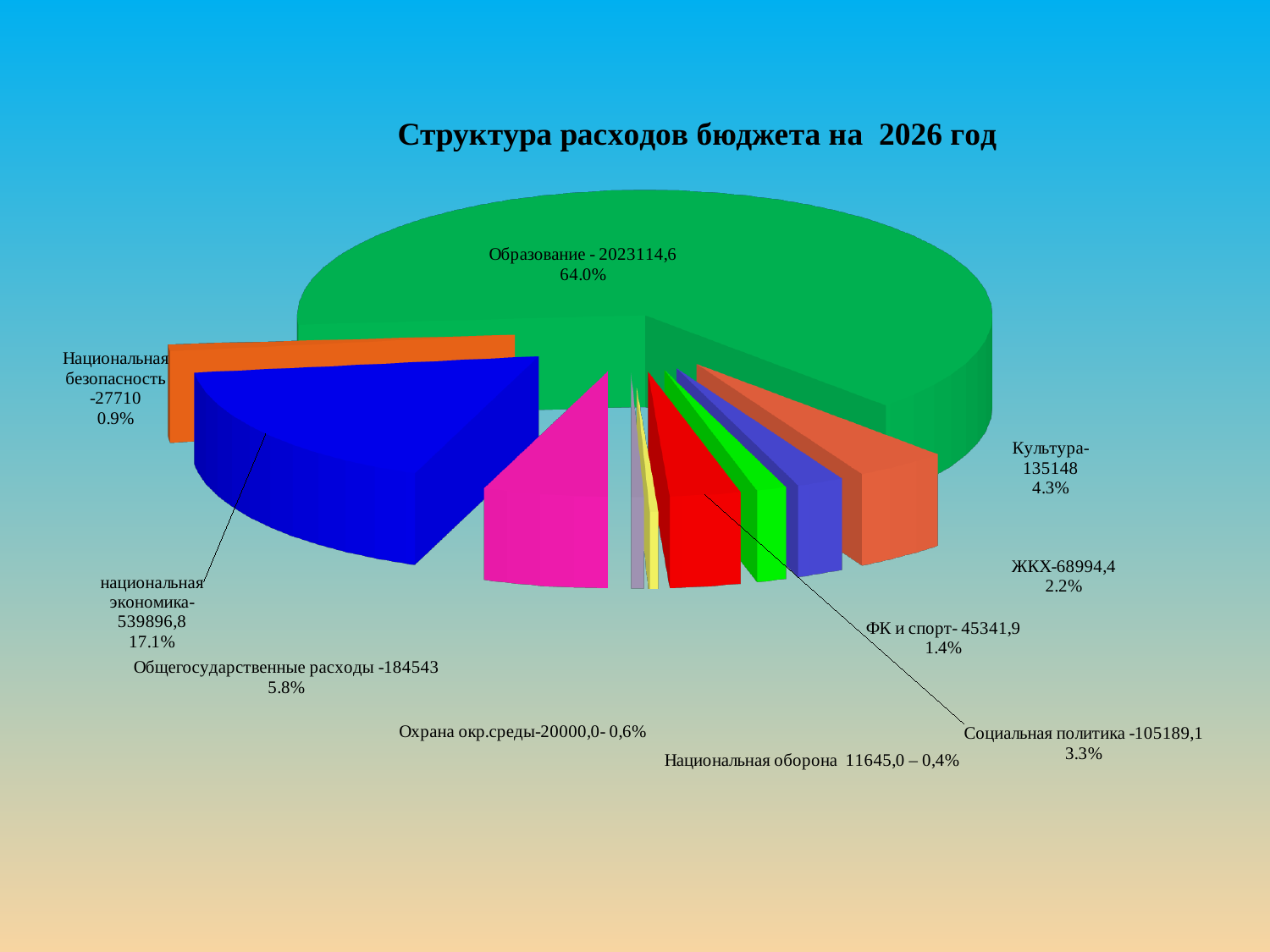
How many categories are shown in the pie chart? 10 Which is larger, the share for Социальная политика or the share for ФК и спорт? Социальная политика What is the title of the chart? Структура расходов бюджета на 2026 год What is the value shown for национальная экономика? 539896,8 Which category has the largest share of the pie? Образование What kind of chart is shown on the slide? pie chart What is the value shown for ЖКХ? 68994,4 What is the difference in percentage points between the shares of Образование and национальная экономика? 46.9 Which category has the smallest share of the pie? Национальная оборона What percentage is shown for Культура? 4.3% What share of the pie does Образование account for? 64.0% What percentage is shown for Общегосударственные расходы? 5.8%